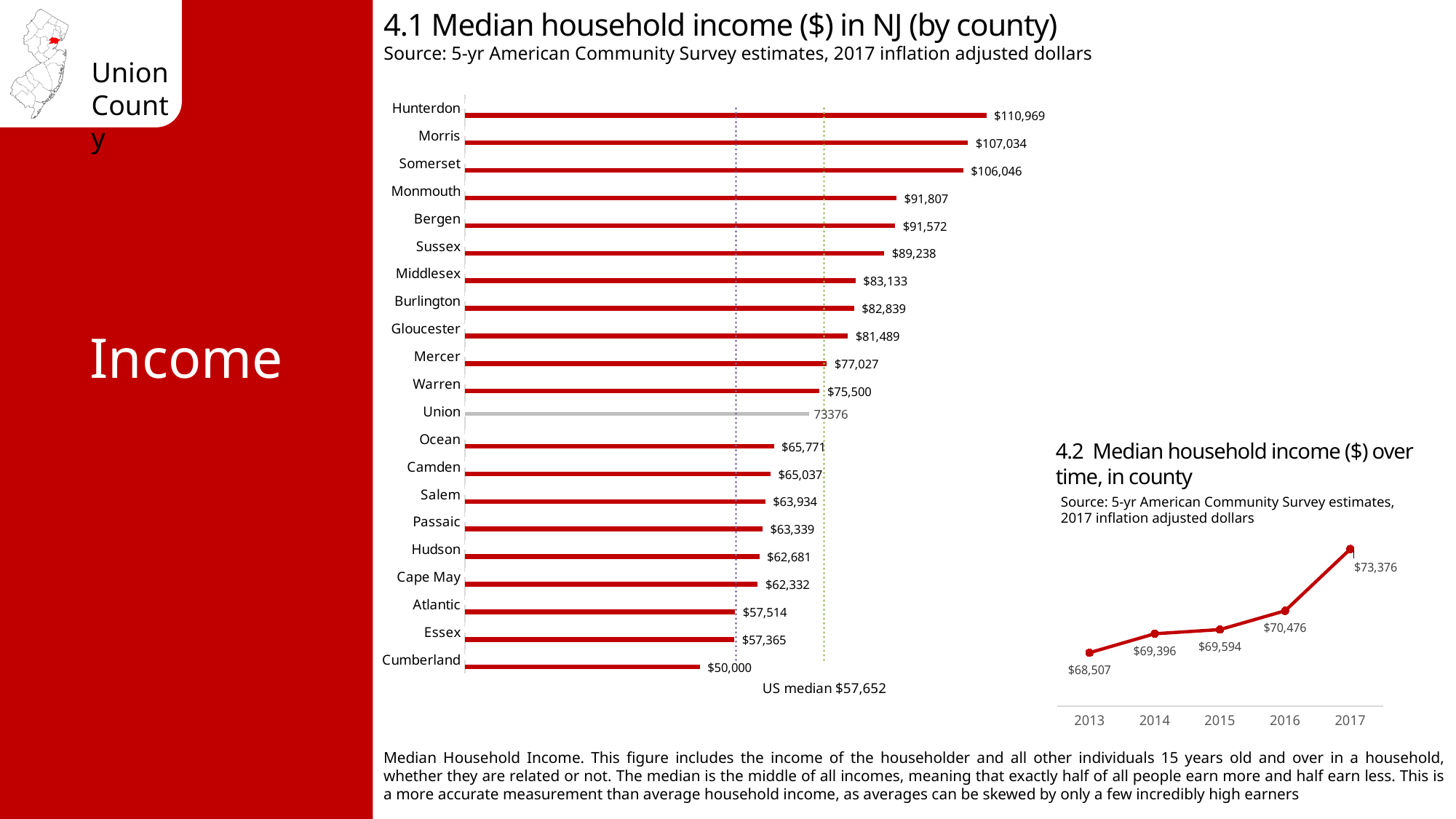
In chart 4.1 (Median household income in NJ by county), which county has the highest median household income? Hunterdon What type of chart is chart 4.1 (Median household income in NJ by county)? Bar chart In chart 4.1 (Median household income in NJ by county), what is the difference between the values for Morris and Somerset? $988 In chart 4.1 (Median household income in NJ by county), which county has the lowest median household income? Cumberland In chart 4.2 (Median household income over time, in county), what is the difference between the 2017 and 2013 values? $4,869 In chart 4.2 (Median household income over time, in county), what is the value for 2015? $69,594 In chart 4.1 (Median household income in NJ by county), which has a higher median household income, Mercer or Ocean? Mercer In chart 4.1 (Median household income in NJ by county), what is the value shown for Union? 73376 In chart 4.2 (Median household income over time, in county), do the values rise or fall from 2013 to 2017? Rise In chart 4.1 (Median household income in NJ by county), what is the median household income for Hunterdon? $110,969 In chart 4.2 (Median household income over time, in county), how many years are plotted? 5 In chart 4.1 (Median household income in NJ by county), how many counties are plotted? 21